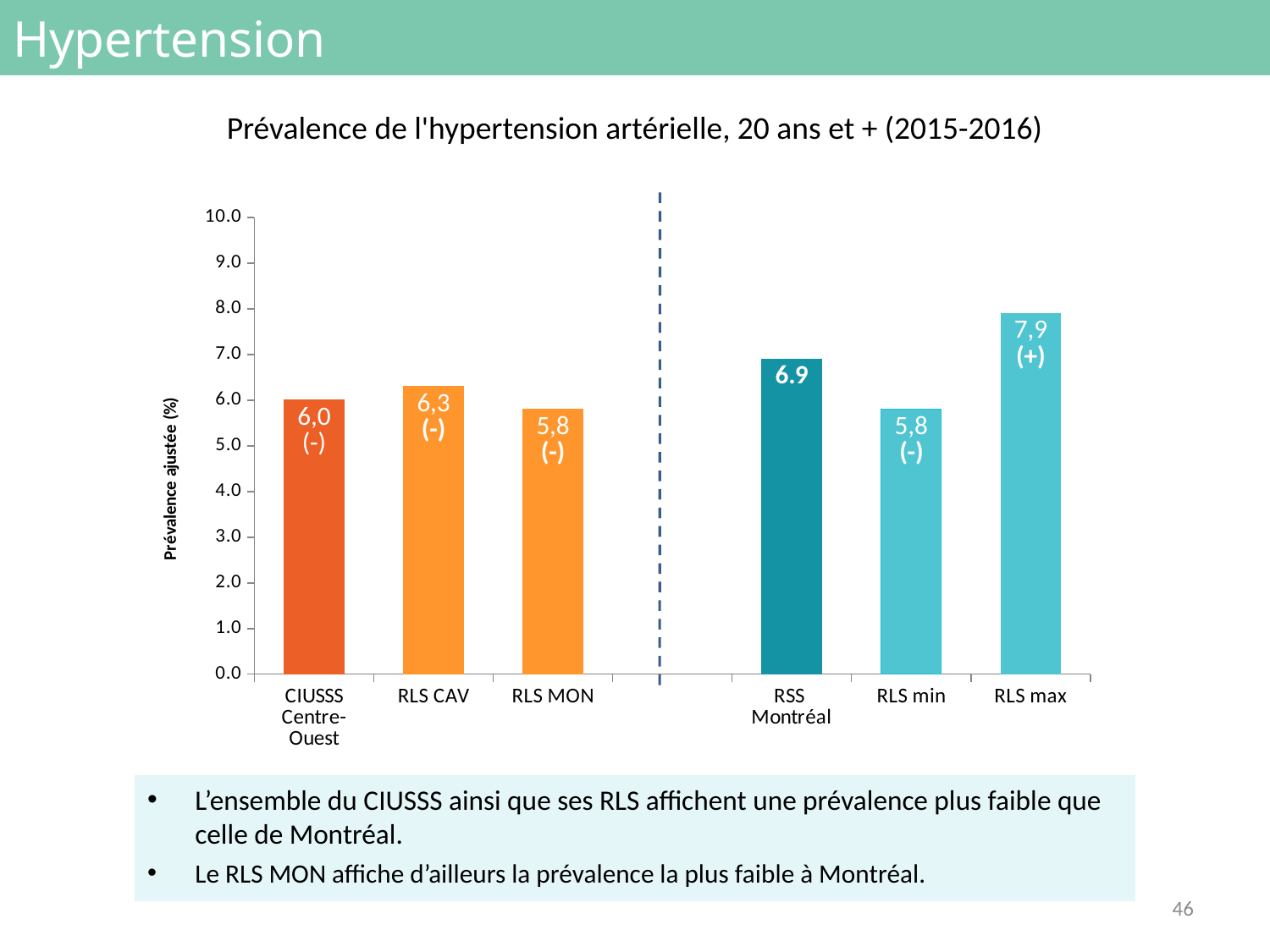
What is the value for RLS CAV? 6,3 How many categories are shown on the x axis? 6 What is the difference between the values for RLS CAV and CIUSSS Centre-Ouest? 0,3 Which is larger, the value for RSS Montréal or the value for CIUSSS Centre-Ouest? RSS Montréal What is the value for CIUSSS Centre-Ouest? 6,0 What is the value for RSS Montréal? 6.9 Among CIUSSS Centre-Ouest, RLS CAV and RLS MON, which has the lowest value? RLS MON Which category has the highest value? RLS max Is the value for RLS max greater or less than 7.0? greater What is the difference between the values for RLS max and RSS Montréal? 1,0 What kind of chart is shown on the slide? bar chart What is the value for RLS max? 7,9